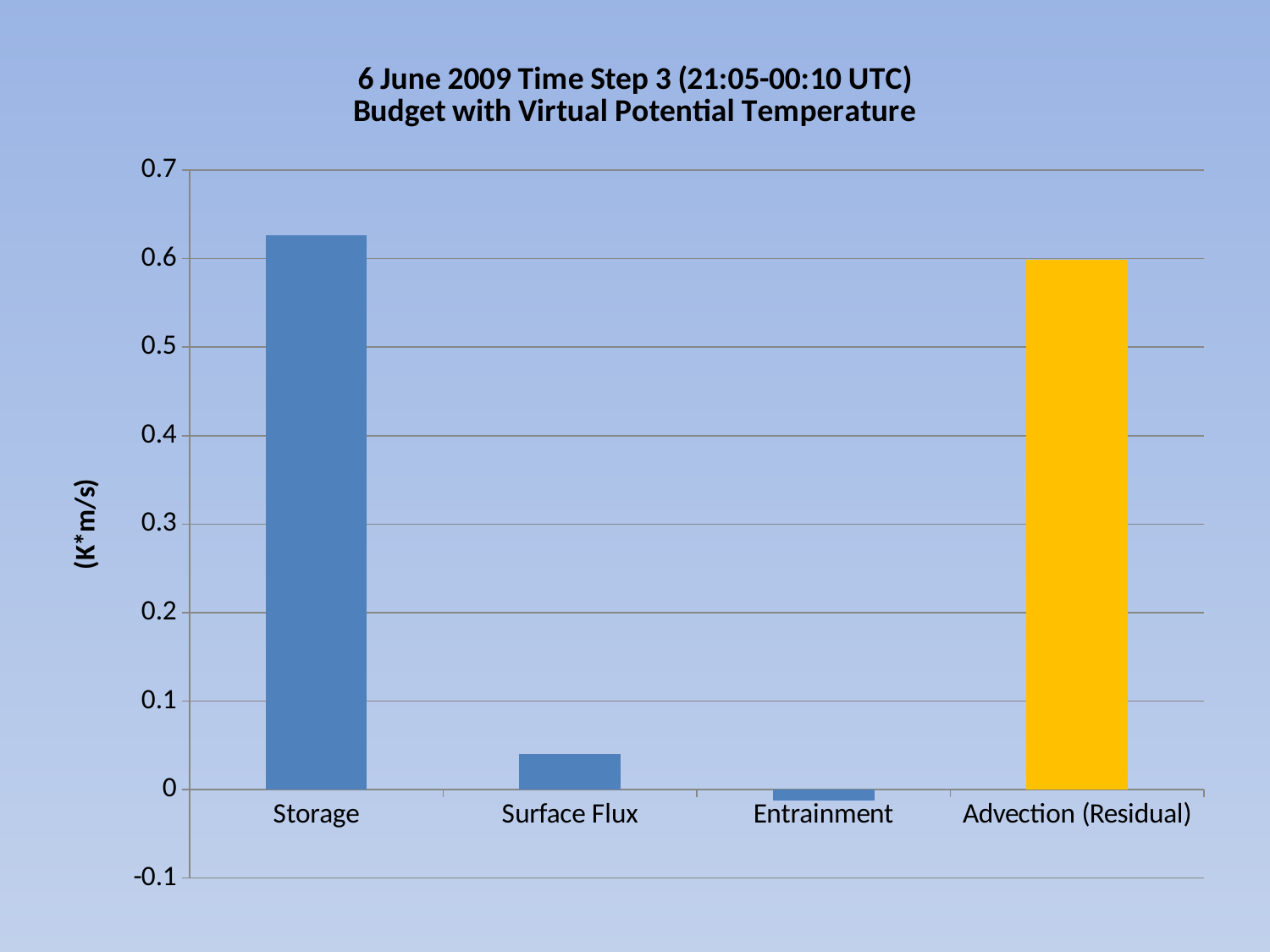
Is the value for Surface Flux greater or less than 0.1? less Which category has the lowest value? Entrainment Is the value for Advection (Residual) greater or less than 0.5? greater What kind of chart is shown on the slide? bar chart What is the label on the y axis? (K*m/s) Which category's bar is coloured yellow rather than blue? Advection (Residual) Which is larger, the value for Advection (Residual) or the value for Surface Flux? Advection (Residual) Is the value for Entrainment greater or less than 0? less How many categories are plotted on the x axis? 4 Which is larger, the value for Surface Flux or the value for Entrainment? Surface Flux Which category has the highest value? Storage